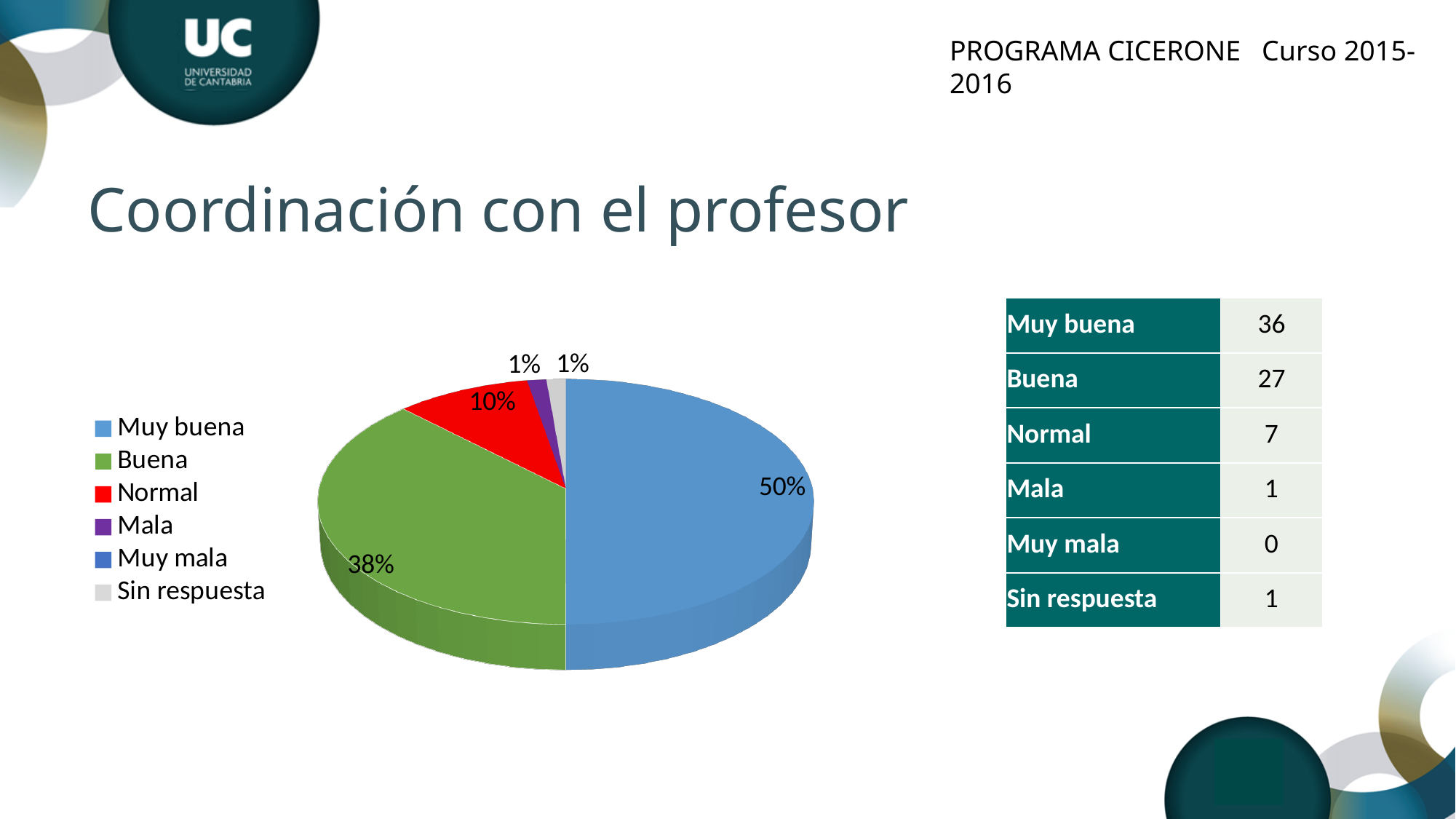
What kind of chart is shown on the slide? Pie chart Which slice is larger, Buena or Normal? Buena How many categories does the legend of the pie chart list? 6 What is the title of the slide containing the pie chart? Coordinación con el profesor What colour is the Normal slice in the pie chart? Red What is the difference in percentage points between the Muy buena slice and the Buena slice? 12% What percentage of the pie chart does Normal represent? 10% What percentage of the pie chart does Sin respuesta represent? 1% Which category has the largest slice of the pie chart? Muy buena What percentage of the pie chart does Buena represent? 38% What percentage of the pie chart does Mala represent? 1% What percentage of the pie chart does Muy buena represent? 50%